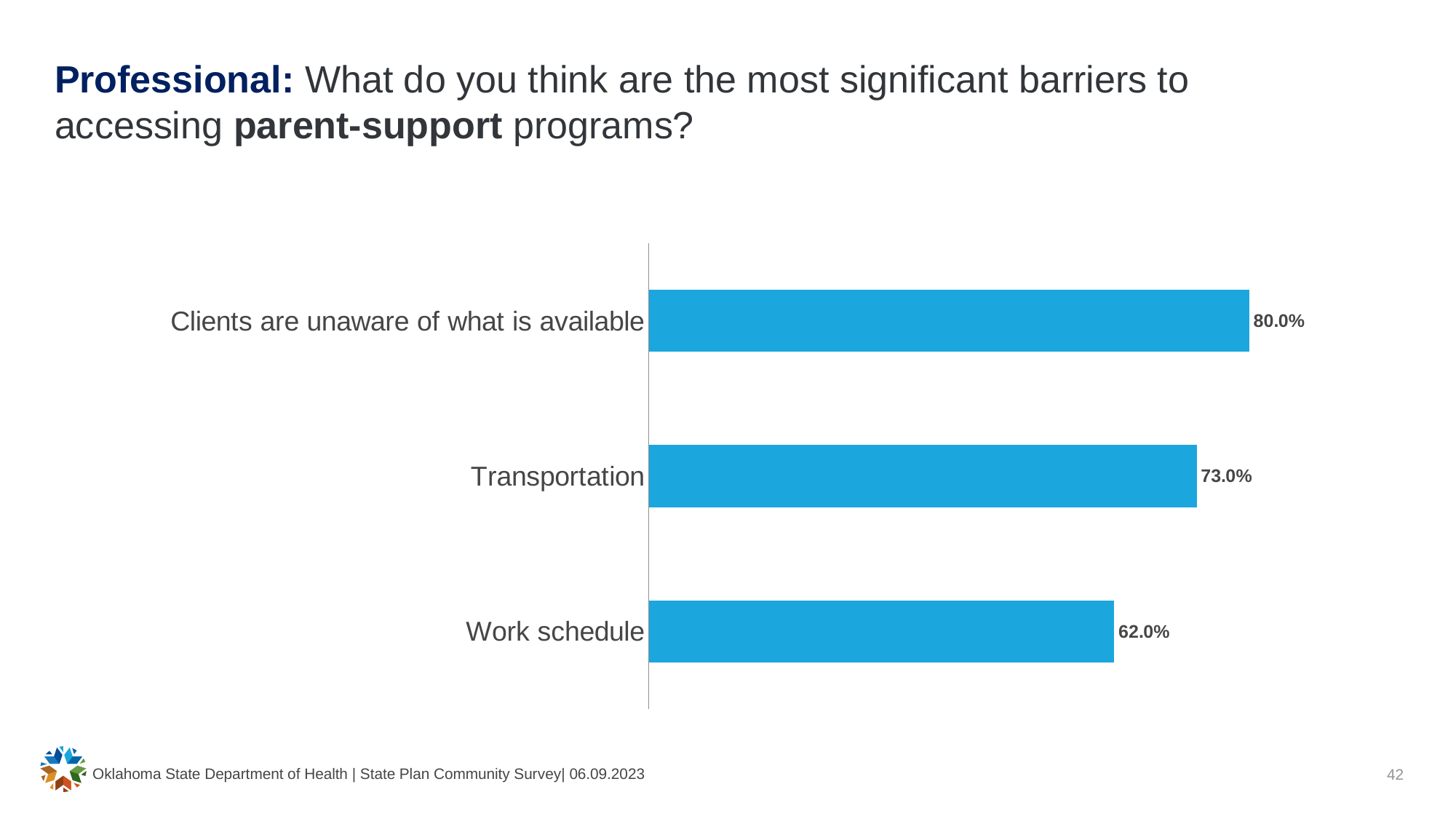
What is the value for Transportation? 73.0% What is the difference between the values for Transportation and Work schedule? 11.0% Which category has the lowest value? Work schedule How many categories are shown in the chart? 3 Which category is listed at the top of the chart? Clients are unaware of what is available What is the value for Clients are unaware of what is available? 80.0% Which category has the highest value? Clients are unaware of what is available What colour are the bars in the chart? Blue What is the difference between the values for Clients are unaware of what is available and Transportation? 7.0% What kind of chart is shown on the slide? Bar chart Which is larger, the value for Transportation or the value for Work schedule? Transportation What is the value for Work schedule? 62.0%